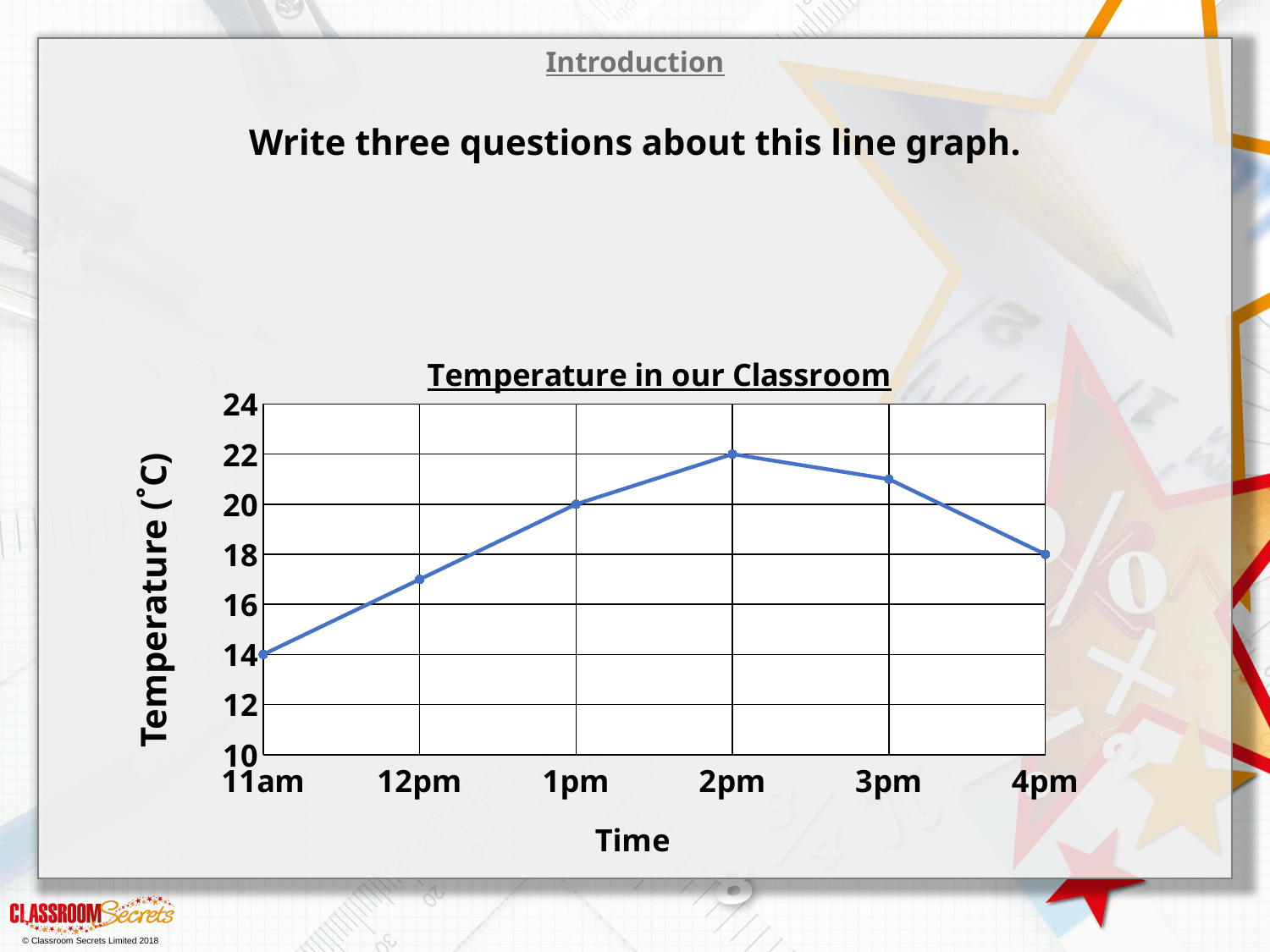
What type of chart is shown on the slide? line chart At which time is the temperature highest? 2pm What is the title of the chart? Temperature in our Classroom How many time points are plotted on the chart? 6 What is the temperature at 11am? 14 What is the difference between the temperature at 2pm and the temperature at 11am? 8 Which is higher, the temperature at 1pm or at 4pm? 1pm At which time is the temperature lowest? 11am What is the temperature at 2pm? 22 Is the temperature at 12pm greater or less than 16? greater What is the temperature at 1pm? 20 What is the temperature at 4pm? 18